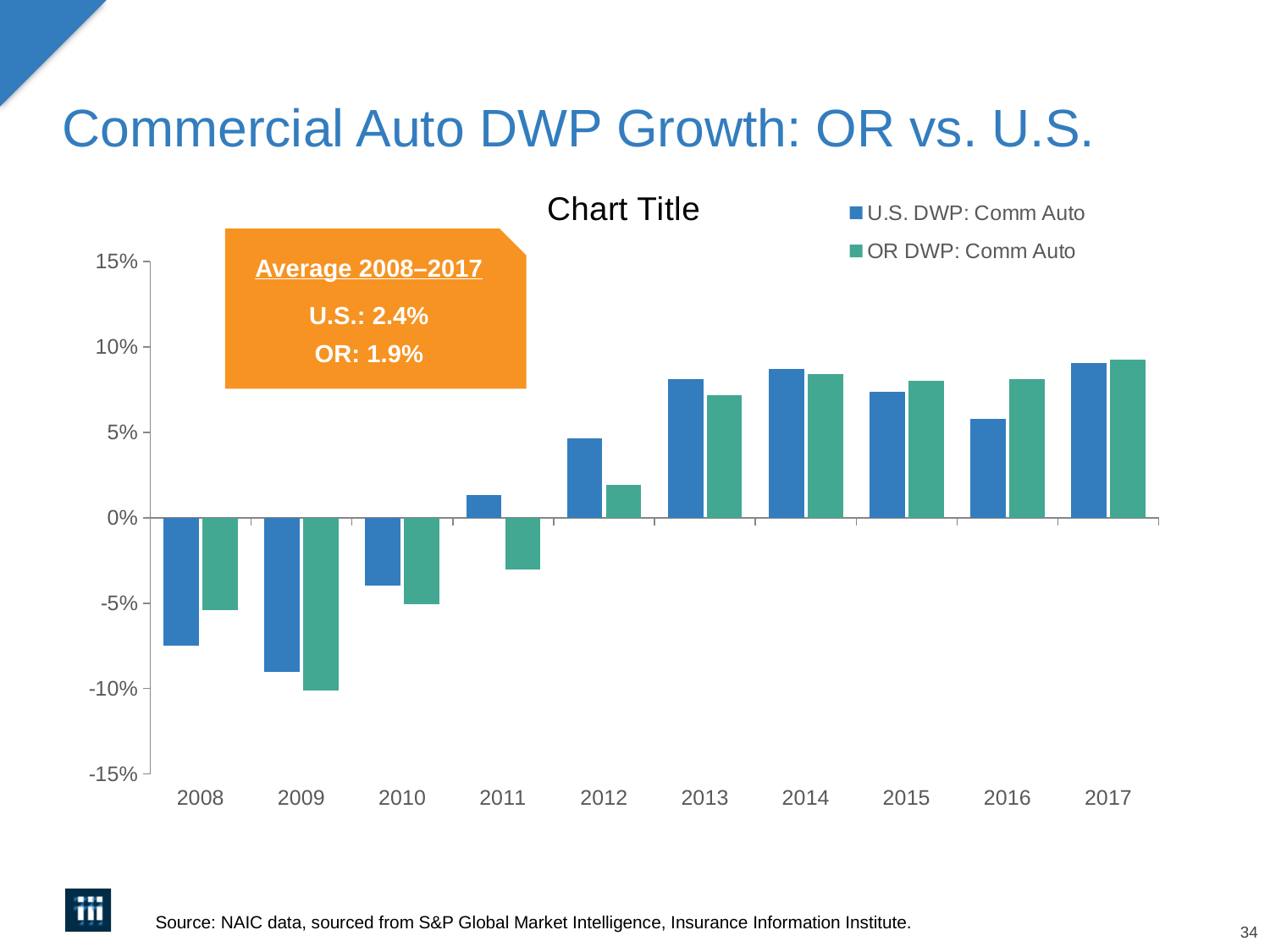
According to the text box on the chart, what is the U.S. average for 2008–2017? 2.4% How many years are shown on the x axis? 10 In 2012, which series has the larger value, U.S. DWP: Comm Auto or OR DWP: Comm Auto? U.S. DWP: Comm Auto Is the OR DWP: Comm Auto value for 2011 greater or less than 0%? less Is the OR DWP: Comm Auto value for 2016 greater or less than 5%? greater Is the U.S. DWP: Comm Auto value for 2008 greater or less than -5%? less In which year is the OR DWP: Comm Auto value lowest? 2009 How many series does the legend list? 2 In 2016, which series has the larger value, U.S. DWP: Comm Auto or OR DWP: Comm Auto? OR DWP: Comm Auto What kind of chart is shown on the slide? bar chart In which year is the U.S. DWP: Comm Auto value lowest? 2009